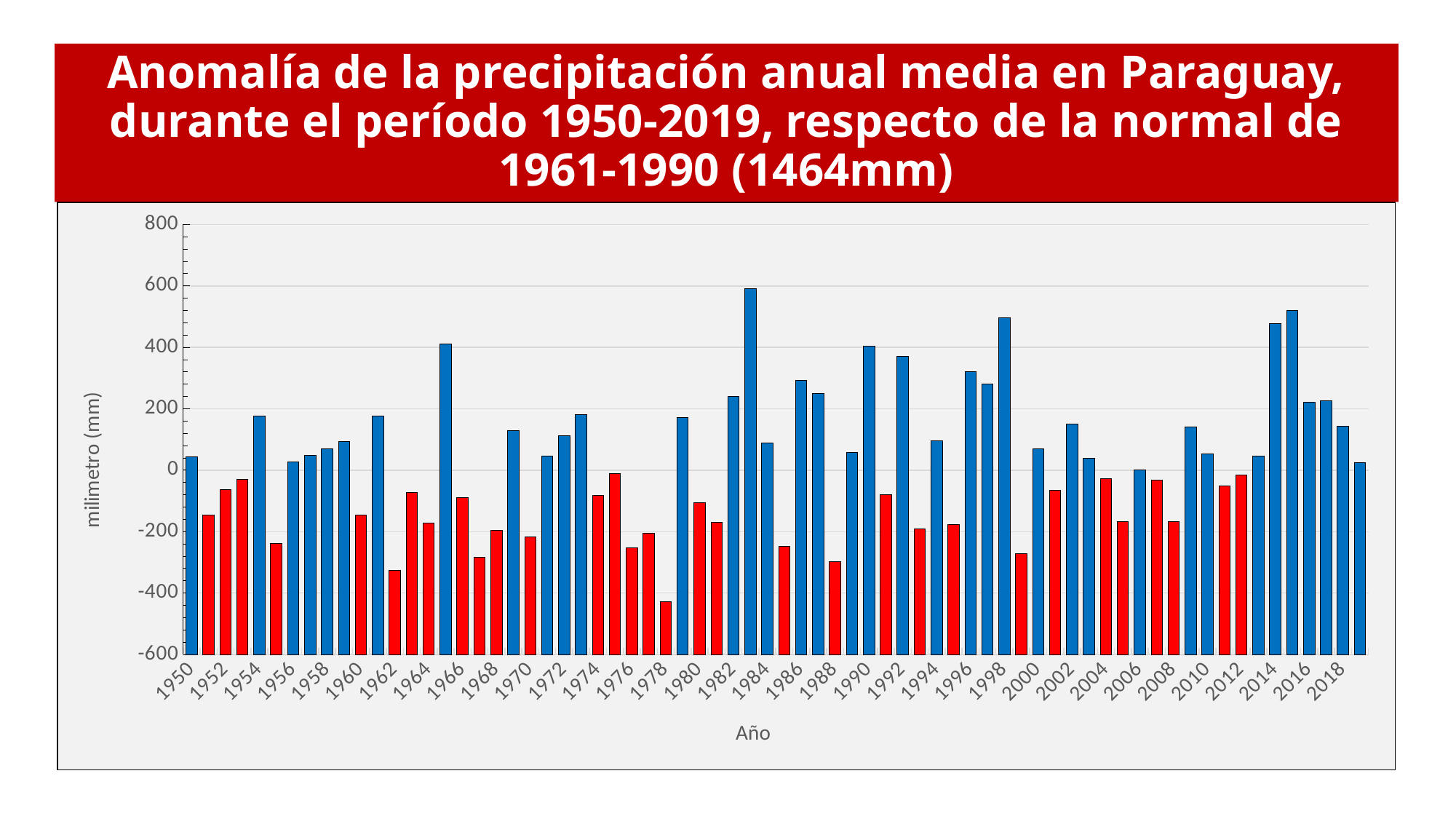
What kind of chart is shown on the slide? bar chart Is the value for 1983 greater or less than 400? greater Is the value for 1985 greater or less than 200? less What is the label of the vertical axis? milimetro (mm) Which year has the larger anomaly, 1983 or 2015? 1983 Is the value for 1962 greater or less than -200? less Which year has the highest precipitation anomaly? 1983 Which year has the lower anomaly, 1978 or 1962? 1978 How many years (bars) are plotted in the chart? 70 Which year has the lowest precipitation anomaly? 1978